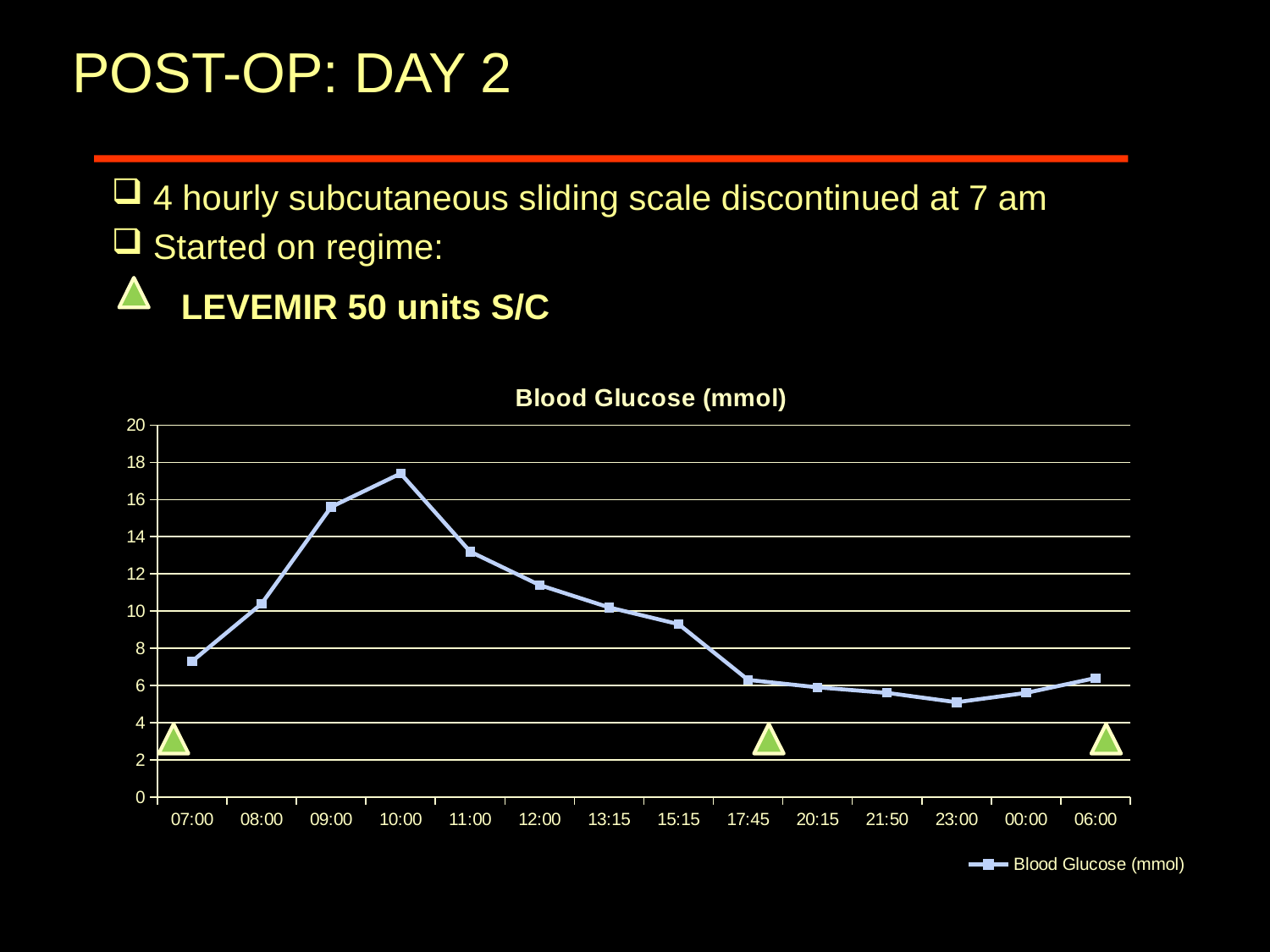
At which time is the blood glucose value highest? 10:00 Is the blood glucose value at 07:00 greater or less than 8? less Do the blood glucose values rise or fall between 10:00 and 23:00? fall How many series does the chart legend list? 1 Is the blood glucose value at 09:00 greater or less than 14? greater What kind of chart is shown on the slide? line chart How many time points are plotted on the x axis of the chart? 14 Which has the higher blood glucose value, 09:00 or 11:00? 09:00 Is the blood glucose value at 23:00 greater or less than 6? less At which time is the blood glucose value lowest? 23:00 What is the title of the chart? Blood Glucose (mmol)